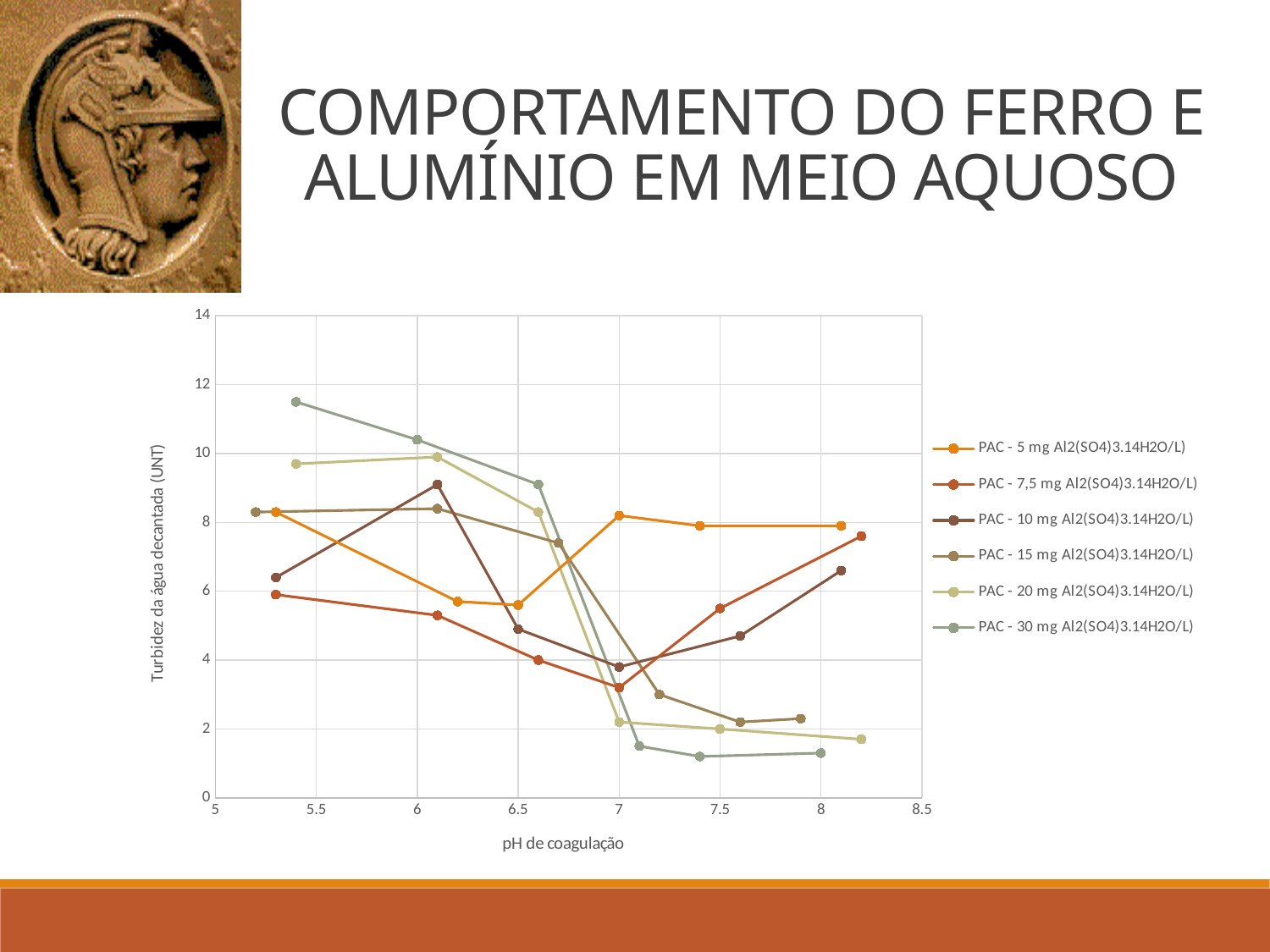
Is the value for PAC - 30 mg Al2(SO4)3.14H2O/L at pH 5.4 greater or less than 10? greater Do the values for PAC - 30 mg Al2(SO4)3.14H2O/L generally rise or fall as pH increases? fall What is the title of the x axis? pH de coagulação Is the value for PAC - 20 mg Al2(SO4)3.14H2O/L at pH 6.1 greater or less than 8? greater Is the value for PAC - 7,5 mg Al2(SO4)3.14H2O/L at pH 7 greater or less than 4? less At pH 7, which series has the larger value: PAC - 5 mg Al2(SO4)3.14H2O/L or PAC - 20 mg Al2(SO4)3.14H2O/L? PAC - 5 mg Al2(SO4)3.14H2O/L What is the title of the y axis? Turbidez da água decantada (UNT) How many series does the legend list? 6 Which series reaches the highest turbidity value on the chart? PAC - 30 mg Al2(SO4)3.14H2O/L What kind of chart is shown on the slide? line chart